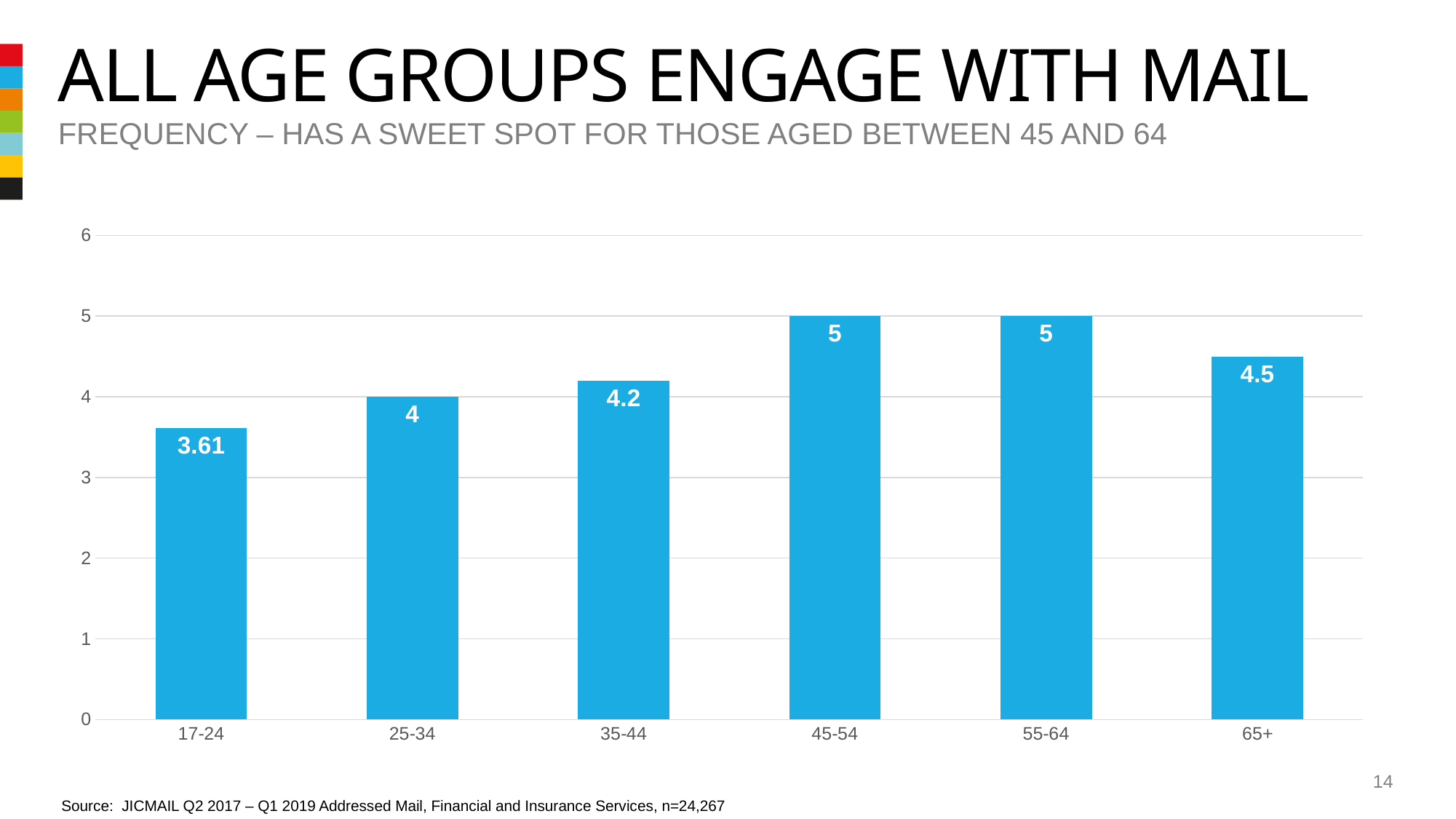
What is the difference between the values for 45-54 and 17-24? 1.39 How many age groups are shown on the chart? 6 What kind of chart is shown on the slide? Bar chart Which is larger, the value for 35-44 or the value for 65+? 65+ What is the value for the 65+ age group? 4.5 Do the values rise or fall from the 17-24 group to the 45-54 group? Rise Is the value for 25-34 greater or less than 3? greater What is the difference between the values for 65+ and 25-34? 0.5 Which age group has the lowest value? 17-24 What is the value for the 17-24 age group? 3.61 What is the value for the 35-44 age group? 4.2 Which two age groups share the highest value? 45-54 and 55-64